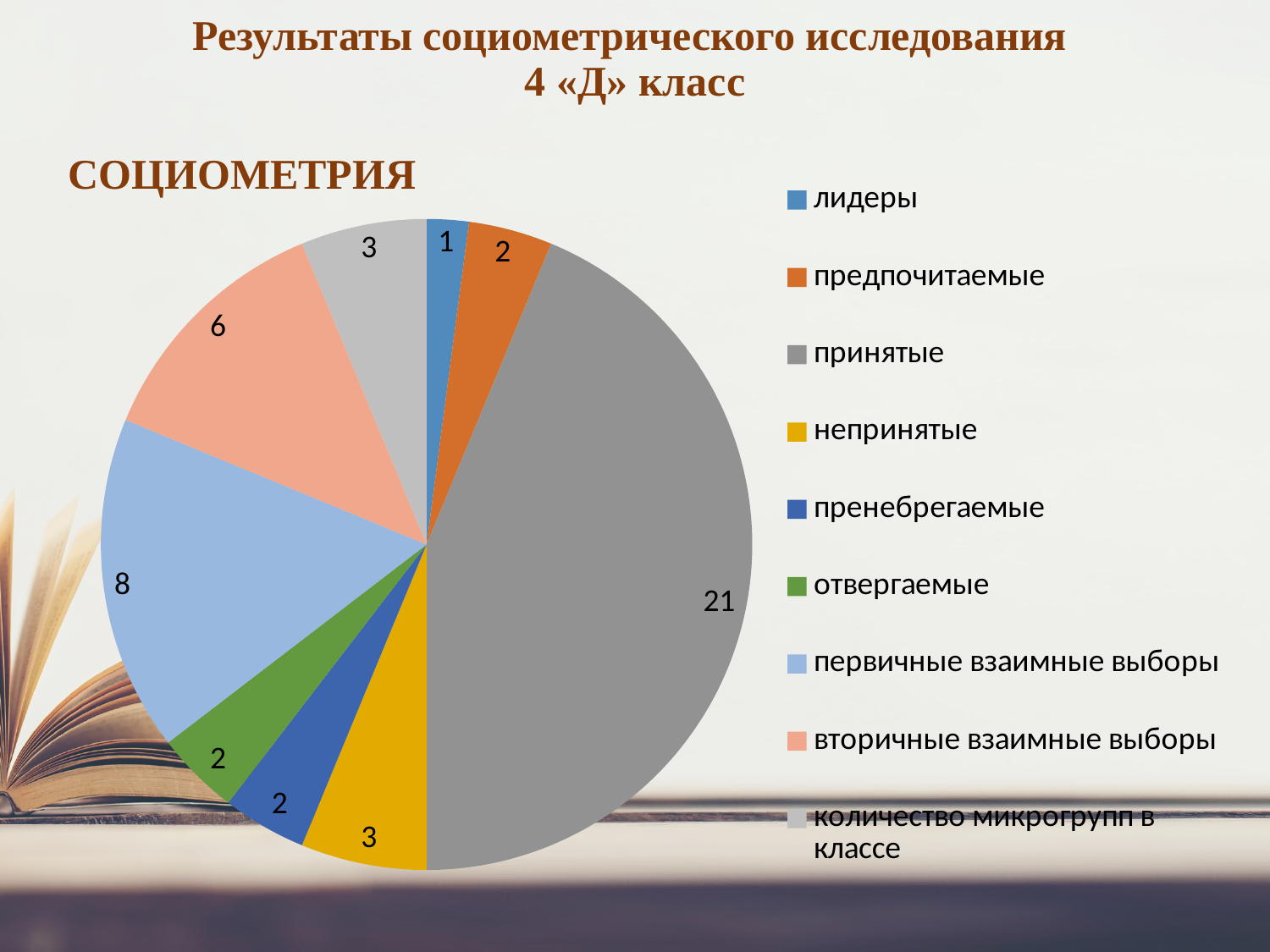
What is the value for первичные взаимные выборы? 8 Which category has the largest slice of the pie? принятые What is the value for лидеры? 1 Which is larger, the value for вторичные взаимные выборы or the value for непринятые? вторичные взаимные выборы What is the title of the chart? СОЦИОМЕТРИЯ What is the value for принятые? 21 Which category has the smallest slice of the pie? лидеры How many categories does the legend list? 9 What is the difference between the values for принятые and первичные взаимные выборы? 13 What is the value for вторичные взаимные выборы? 6 What kind of chart is shown on the slide? pie chart What share of the pie does вторичные взаимные выборы represent? 12.5%